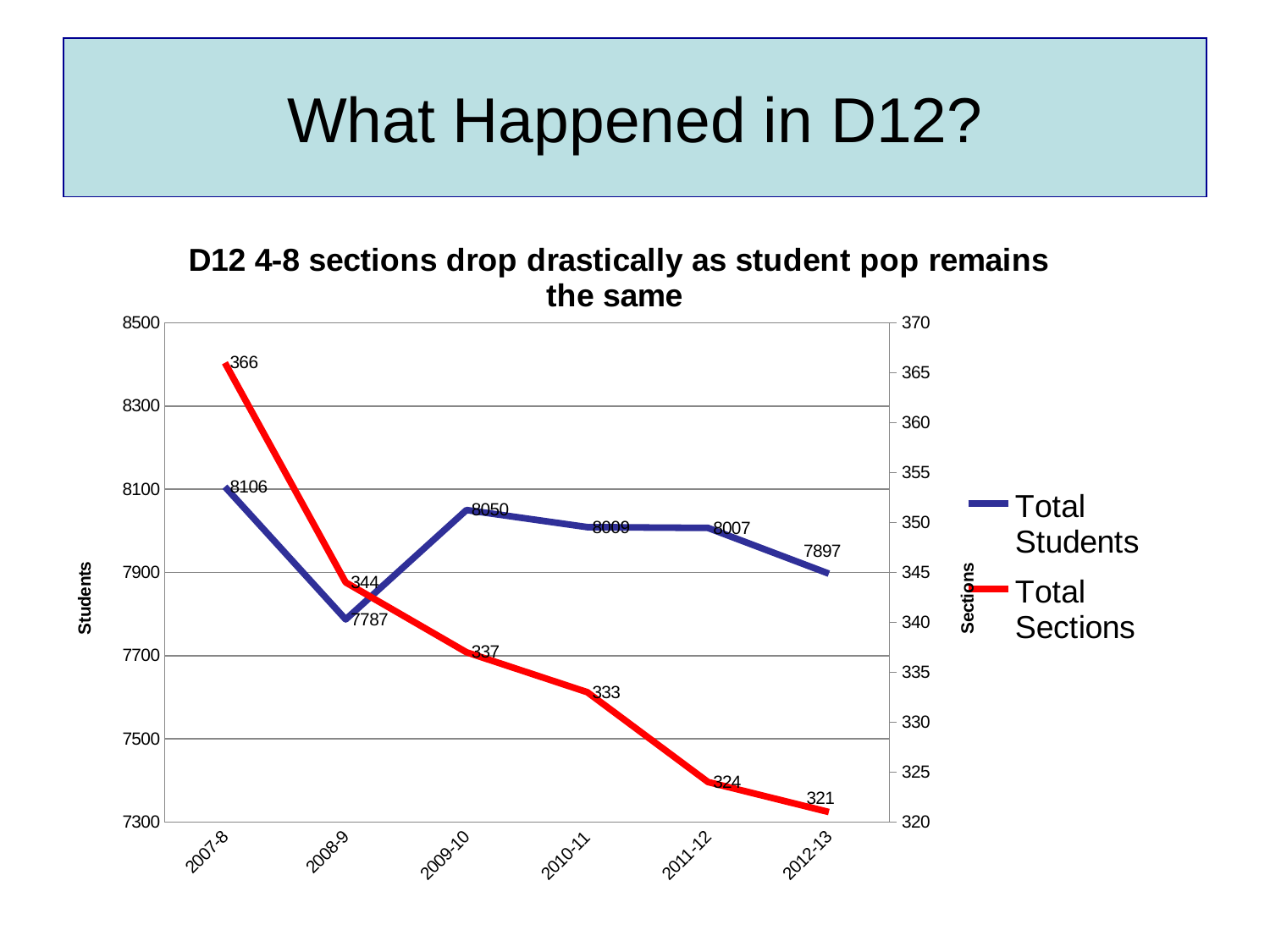
How many series does the legend list? 2 What is the value for Total Sections in 2012-13? 321 How many years are shown on the x axis? 6 What is the difference between Total Students in 2009-10 and 2008-9? 263 What kind of chart is this? line chart What is the value for Total Sections in 2009-10? 337 What is the difference between Total Sections in 2007-8 and 2012-13? 45 What is the value for Total Students in 2007-8? 8106 Does Total Sections rise or fall from 2007-8 to 2012-13? fall In which year is Total Students lowest? 2008-9 Which is larger, Total Students in 2009-10 or in 2012-13? 2009-10 In which year is Total Sections highest? 2007-8